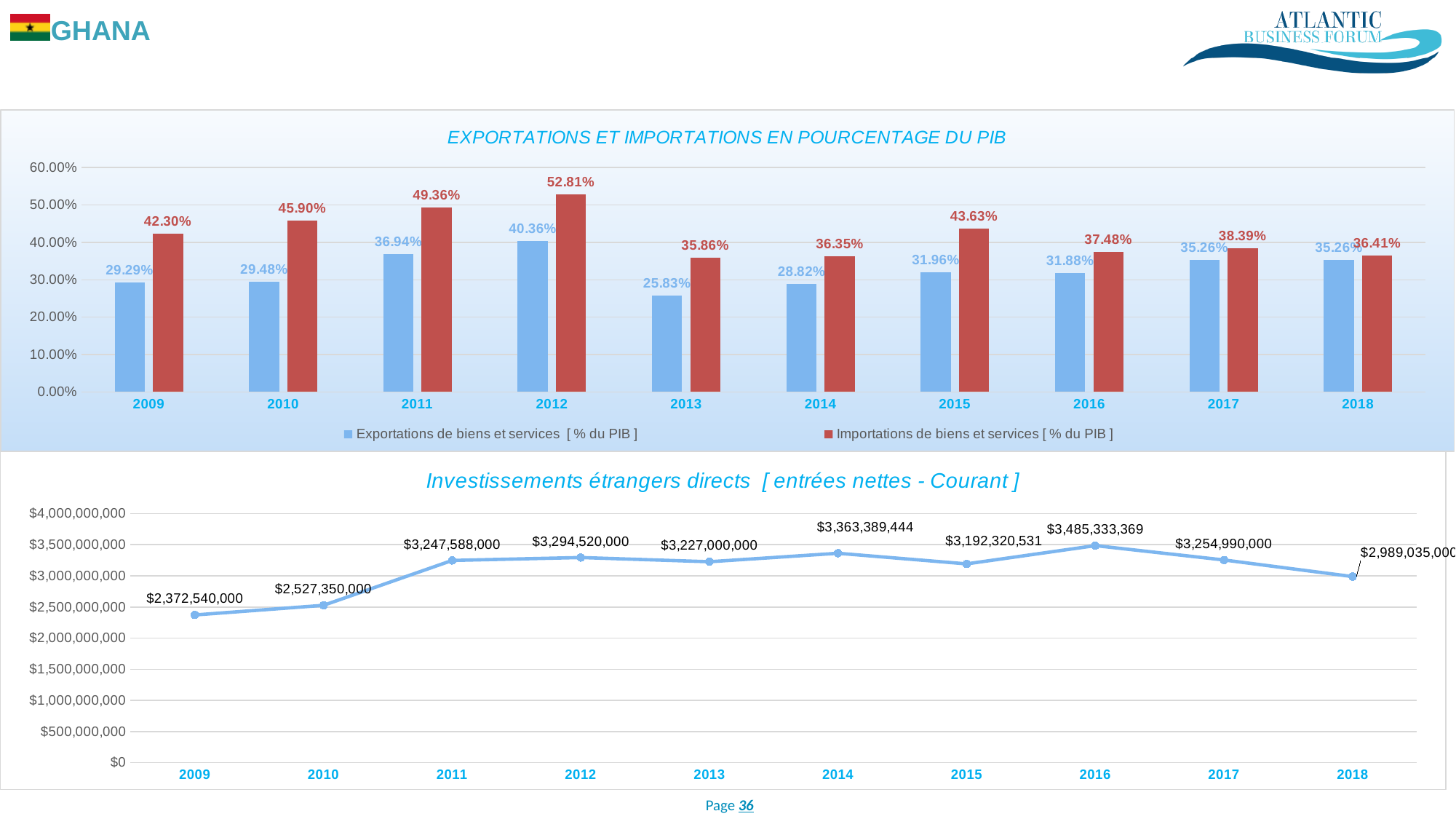
What kind of chart is 'Investissements étrangers directs [entrées nettes - Courant]'? Line chart In the chart 'EXPORTATIONS ET IMPORTATIONS EN POURCENTAGE DU PIB', how many series does the legend list? 2 In the chart 'EXPORTATIONS ET IMPORTATIONS EN POURCENTAGE DU PIB', what is the value of Importations de biens et services for 2012? 52.81% In the chart 'EXPORTATIONS ET IMPORTATIONS EN POURCENTAGE DU PIB', what is the value of Exportations de biens et services for 2013? 25.83% In the chart 'Investissements étrangers directs [entrées nettes - Courant]', which year has the lowest value? 2009 In the chart 'EXPORTATIONS ET IMPORTATIONS EN POURCENTAGE DU PIB', which year has the highest value for Importations de biens et services? 2012 In the chart 'EXPORTATIONS ET IMPORTATIONS EN POURCENTAGE DU PIB', which year has the lowest value for Exportations de biens et services? 2013 In the chart 'Investissements étrangers directs [entrées nettes - Courant]', how many years are plotted? 10 In the chart 'EXPORTATIONS ET IMPORTATIONS EN POURCENTAGE DU PIB', what is the difference between Importations and Exportations in 2011? 12.42% What kind of chart is 'EXPORTATIONS ET IMPORTATIONS EN POURCENTAGE DU PIB'? Bar chart In the chart 'Investissements étrangers directs [entrées nettes - Courant]', what is the value for 2016? $3,485,333,369 In the chart 'Investissements étrangers directs [entrées nettes - Courant]', which is larger, the value for 2014 or the value for 2015? 2014